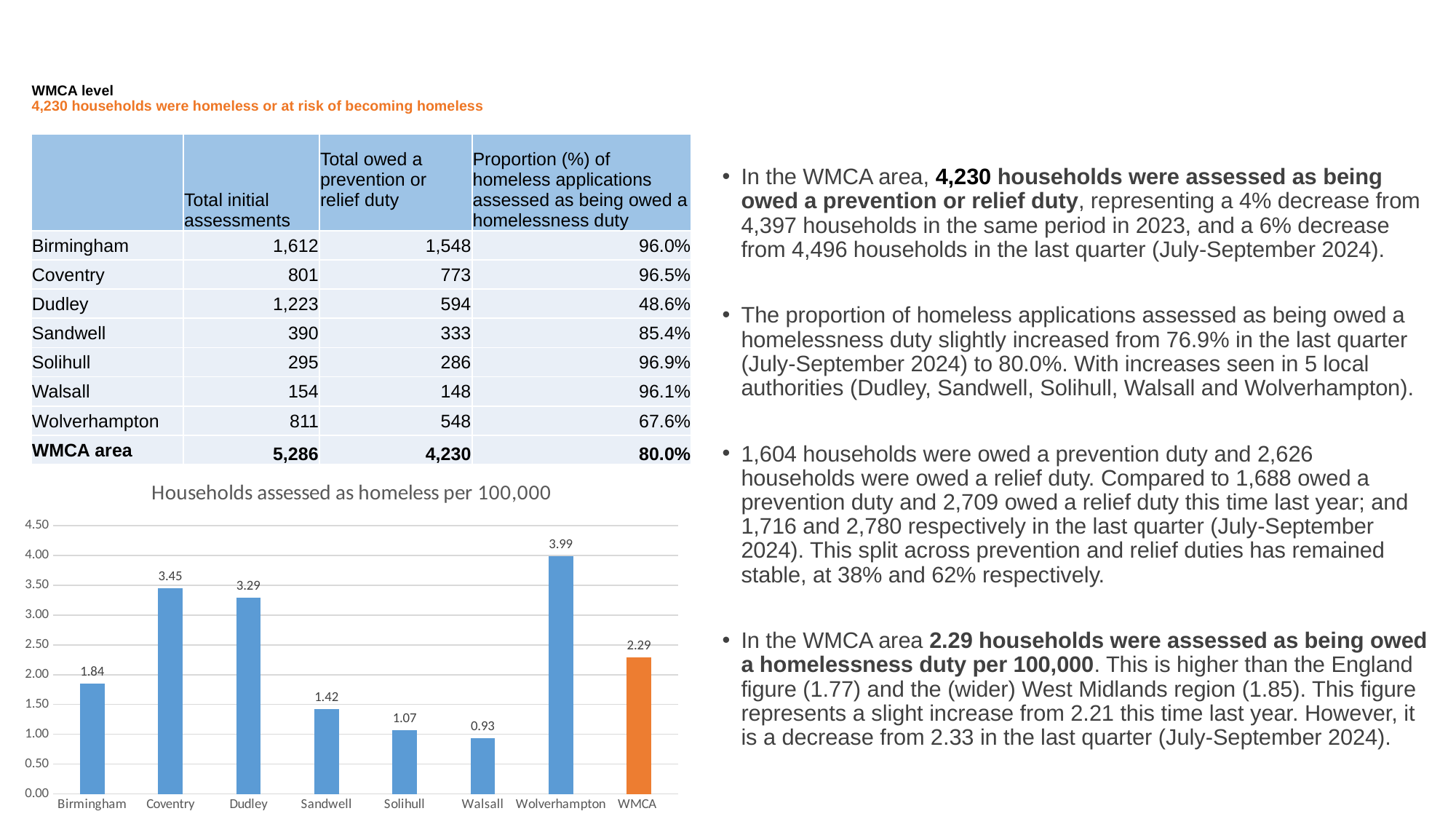
Which category has the highest value in the chart? Wolverhampton Is the value for Dudley in the chart greater or less than 3.00? greater What type of chart is shown on the slide? bar chart How many categories are shown on the x axis of the chart? 8 Which category has the lowest value in the chart? Walsall What is the value for Birmingham in the chart? 1.84 What is the difference between the values for Coventry and Dudley in the chart? 0.16 What is the value for WMCA in the chart? 2.29 Which has a larger value in the chart, Sandwell or Solihull? Sandwell What is the title of the chart on the slide? Households assessed as homeless per 100,000 What is the value for Wolverhampton in the chart? 3.99 Which bar in the chart is coloured orange rather than blue? WMCA